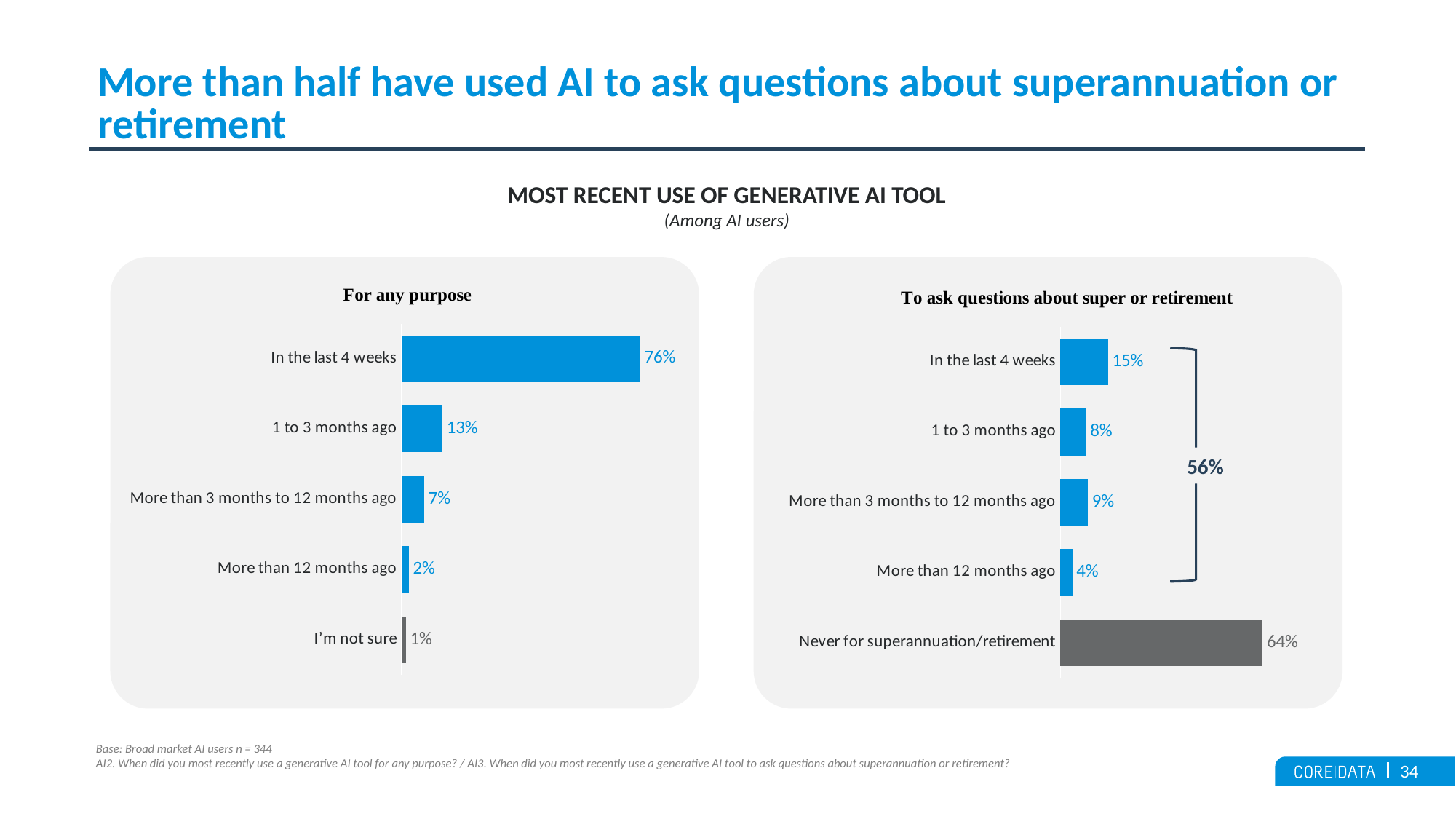
In the 'To ask questions about super or retirement' chart, what is the value for 'More than 3 months to 12 months ago'? 9% In the 'For any purpose' chart, what is the difference between 'In the last 4 weeks' and '1 to 3 months ago'? 63% In the 'To ask questions about super or retirement' chart, which category has the highest value? Never for superannuation/retirement In the 'For any purpose' chart, what is the value for 'In the last 4 weeks'? 76% What kind of chart is the 'To ask questions about super or retirement' chart? Bar chart What is the main title shown above the two charts? MOST RECENT USE OF GENERATIVE AI TOOL In the 'To ask questions about super or retirement' chart, what is the value for 'Never for superannuation/retirement'? 64% In the 'To ask questions about super or retirement' chart, which is larger: 'In the last 4 weeks' or '1 to 3 months ago'? In the last 4 weeks In the 'For any purpose' chart, what is the value for '1 to 3 months ago'? 13% How many categories are shown in the 'For any purpose' chart? 5 In the 'For any purpose' chart, which category has the lowest value? I'm not sure In the 'To ask questions about super or retirement' chart, what total is shown by the bracket grouping the four blue bars? 56%